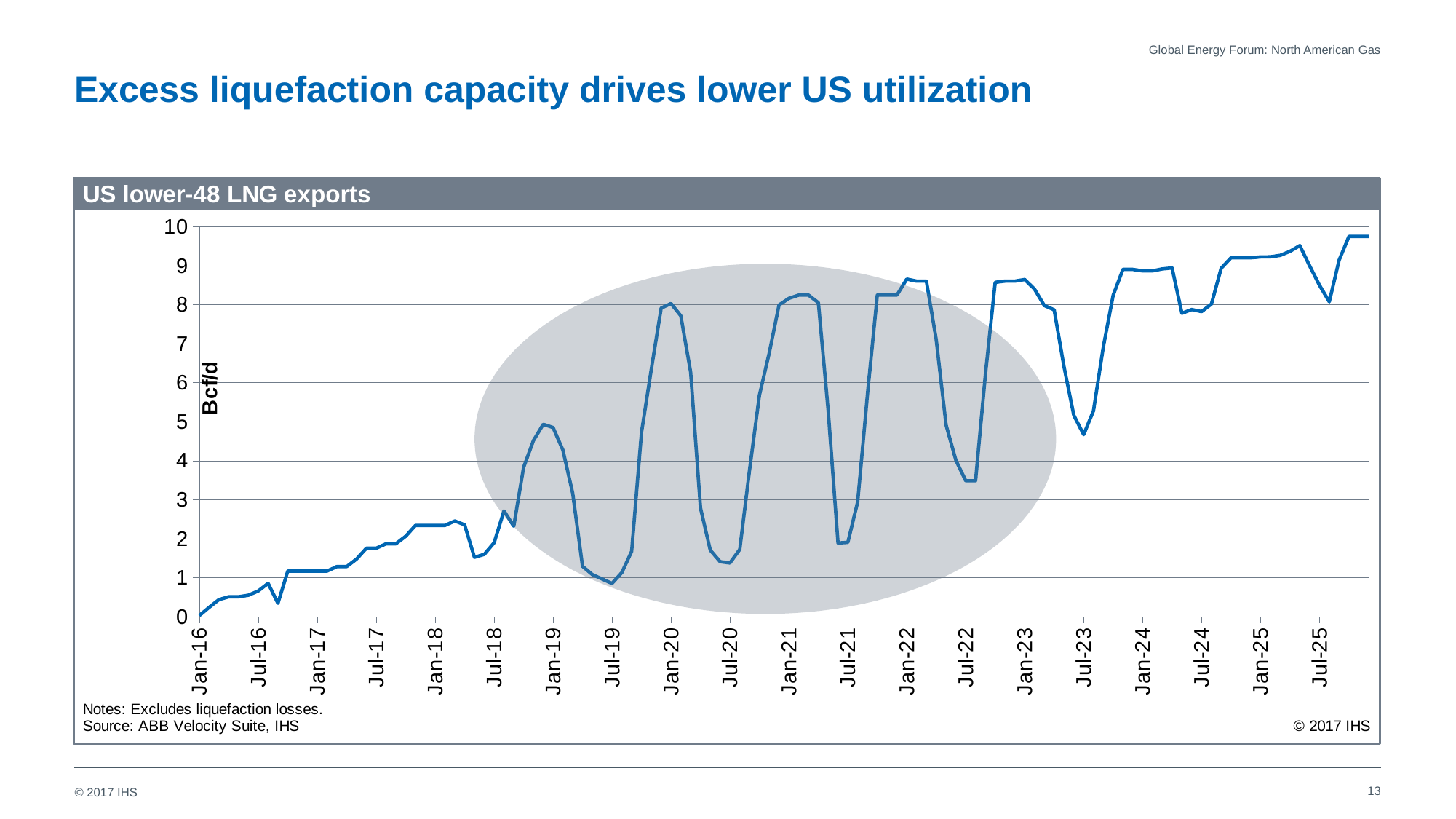
What is the title of the chart? US lower-48 LNG exports What unit is shown on the y-axis of the chart? Bcf/d Overall, do the values rise or fall from Jan-16 to the end of 2025? rise Is the value for Jan-22 greater or less than 7? greater Is the value for Jul-21 greater or less than 4? less Is the value for Jan-17 greater or less than 2? less What kind of chart is shown on the slide? Line chart